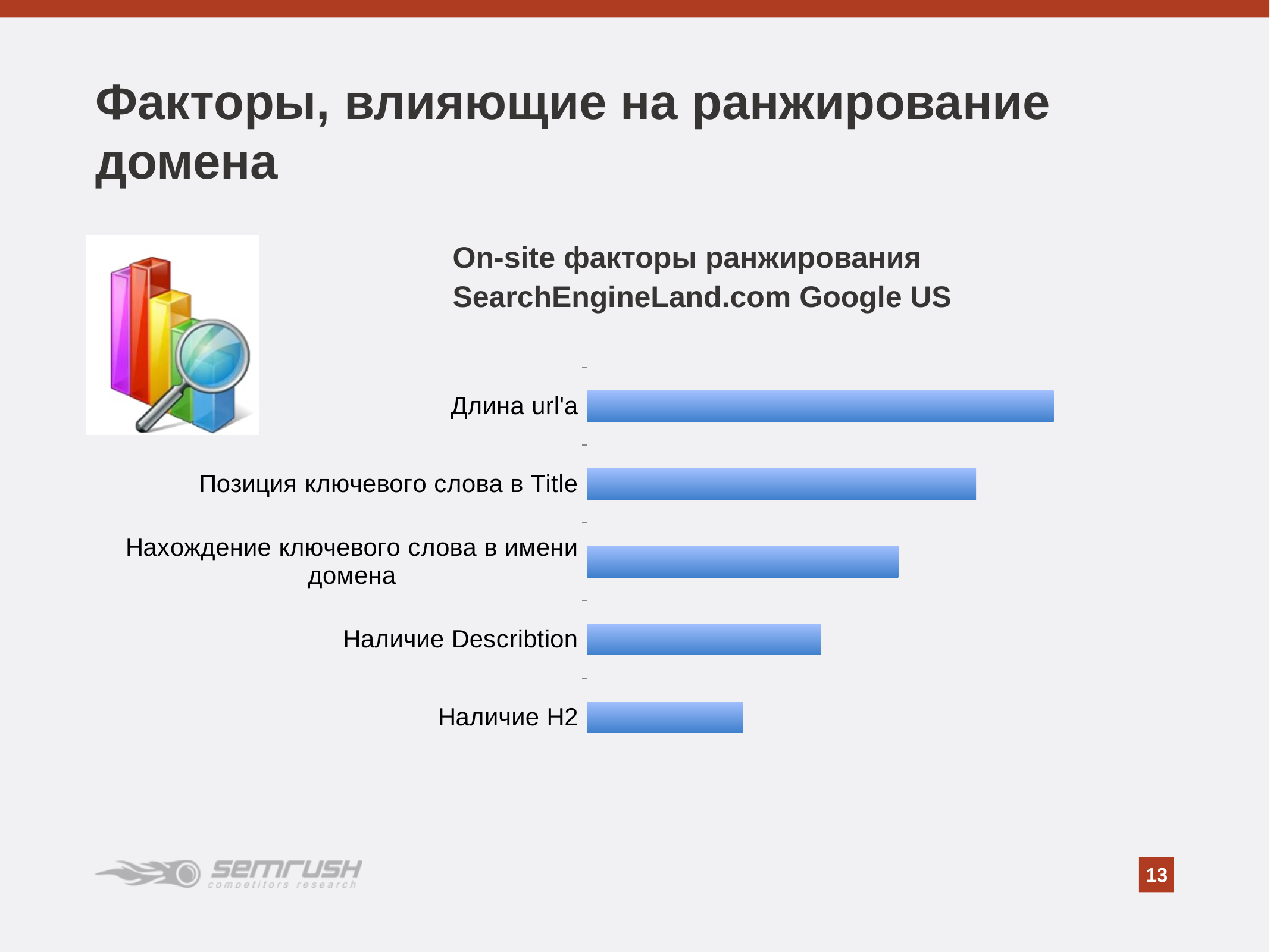
What kind of chart is shown on the slide? bar chart Which category is listed at the top of the chart? Длина url'a How many categories are plotted in the chart? 5 Which category has the longest bar in the chart? Длина url'a Which is larger: the value for Длина url'a or the value for Позиция ключевого слова в Title? Длина url'a Which is larger: the value for Наличие H2 or the value for Нахождение ключевого слова в имени домена? Нахождение ключевого слова в имени домена Which is larger: the value for Позиция ключевого слова в Title or the value for Наличие Describtion? Позиция ключевого слова в Title What is the title of the chart? On-site факторы ранжирования SearchEngineLand.com Google US Do the bar lengths increase or decrease going from the top category to the bottom category? decrease Which category has the shortest bar in the chart? Наличие H2